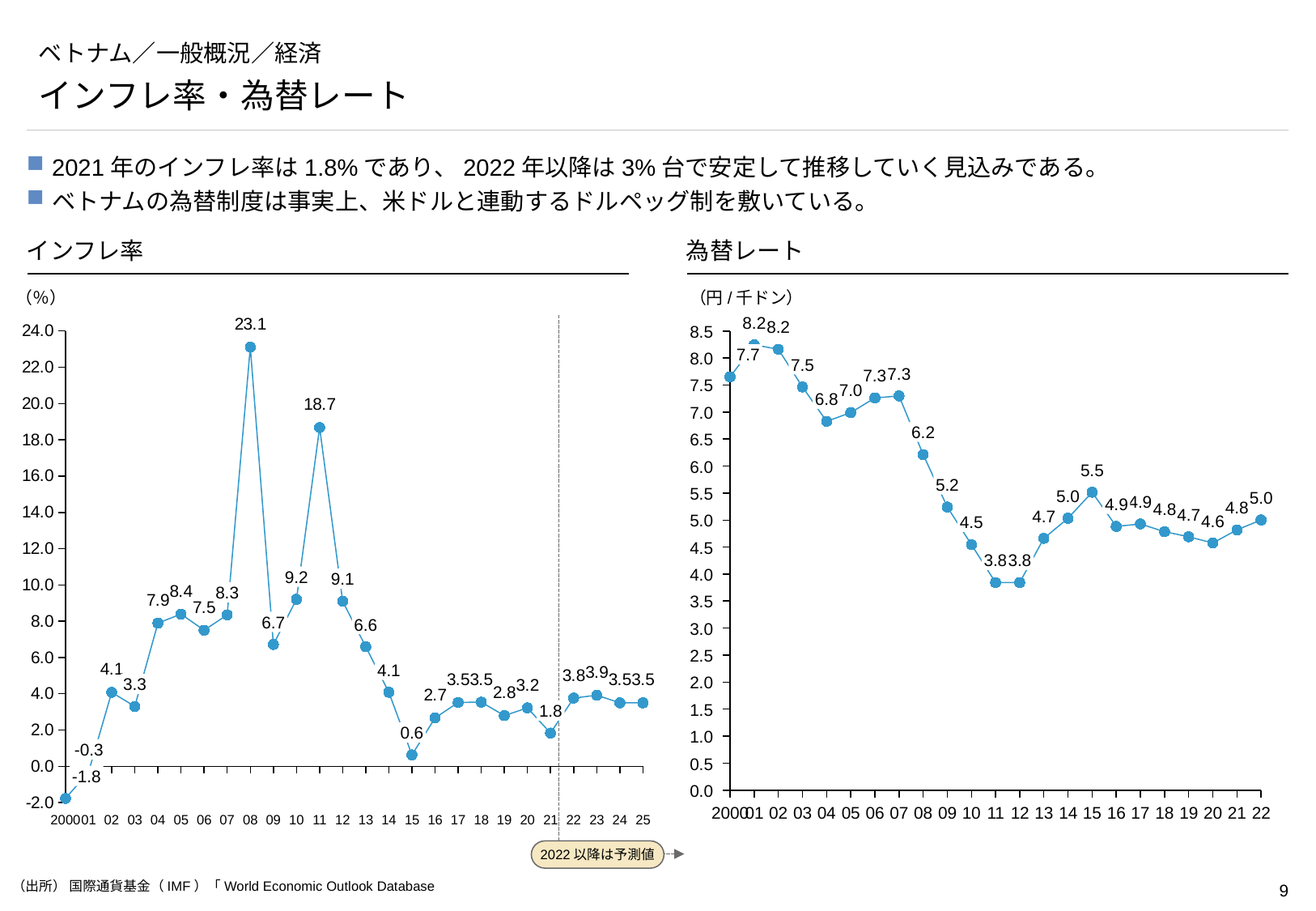
In the インフレ率 chart, which is larger, the value for 2015 or the value for 2016? 2016 In the インフレ率 chart, what is the inflation rate for 2008? 23.1 In the 為替レート chart, what is the value for 2015? 5.5 What type of chart is the 為替レート chart? line chart In the インフレ率 chart, what is the value for 2021? 1.8 In the 為替レート chart, which year has the lowest value? 2011 and 2012 What unit is shown on the y axis of the 為替レート chart? 円/千ドン In the 為替レート chart, what is the difference between the 2001 value and the 2022 value? 3.2 In the インフレ率 chart, which year has the lowest value? 2000 In the 為替レート chart, do the values rise or fall from 2007 to 2011? fall In the インフレ率 chart, which year has the highest value? 2008 In the インフレ率 chart, what is the difference between the 2008 value and the 2011 value? 4.4